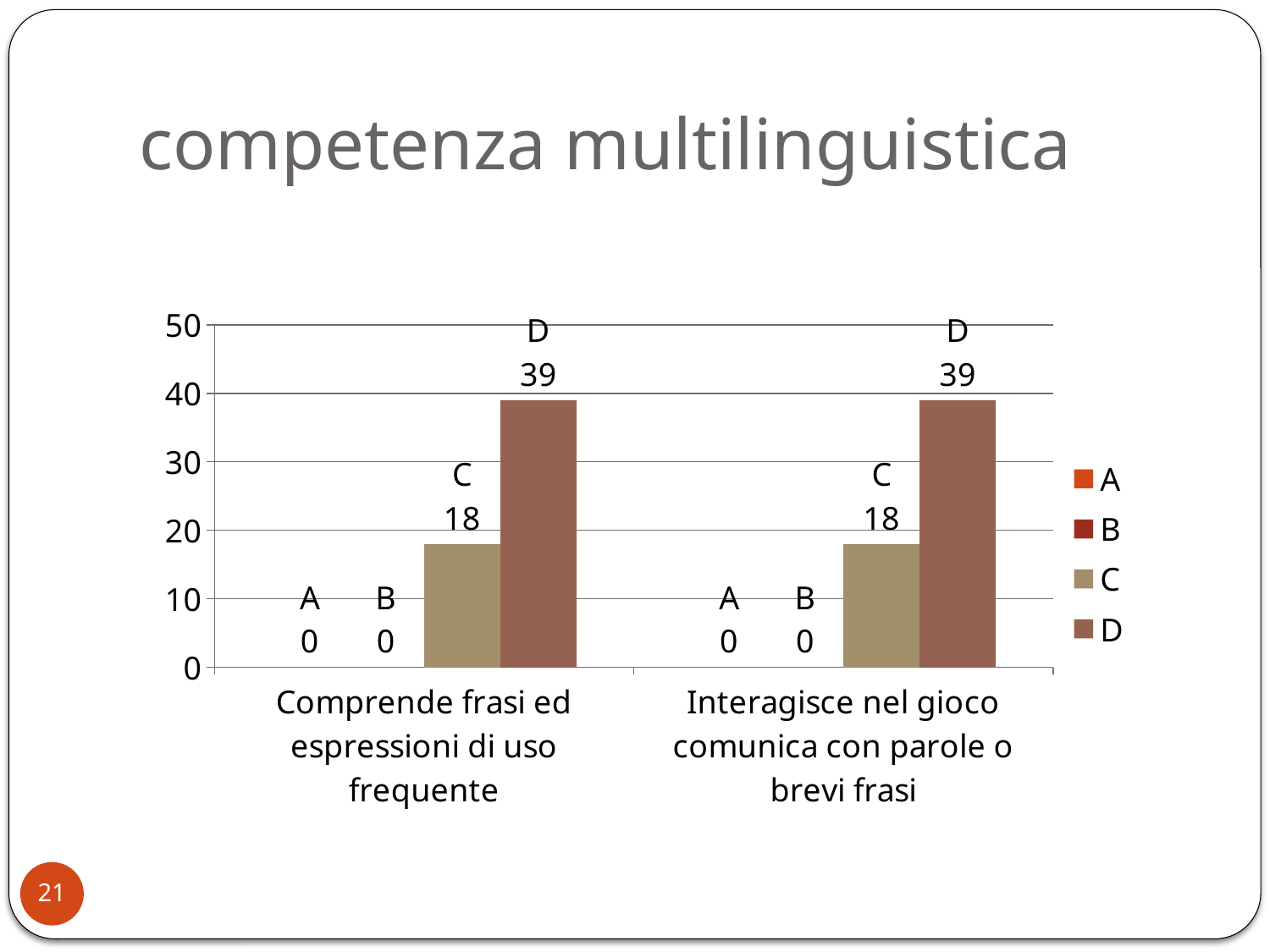
Which series has the highest value in the category "Comprende frasi ed espressioni di uso frequente"? D What is the difference between the values for D and C in the category "Interagisce nel gioco comunica con parole o brevi frasi"? 21 What is the title of the slide containing the chart? competenza multilinguistica How many categories are shown on the x axis? 2 How many series does the legend list? 4 What is the value for series A in the category "Comprende frasi ed espressioni di uso frequente"? 0 What kind of chart is shown on the slide? bar chart Is the value for D in the category "Interagisce nel gioco comunica con parole o brevi frasi" greater or less than 30? greater What is the value for series B in the category "Interagisce nel gioco comunica con parole o brevi frasi"? 0 What is the value for series D in the category "Comprende frasi ed espressioni di uso frequente"? 39 What is the value for series C in the category "Interagisce nel gioco comunica con parole o brevi frasi"? 18 Which is larger in the category "Comprende frasi ed espressioni di uso frequente": the value for C or the value for D? D